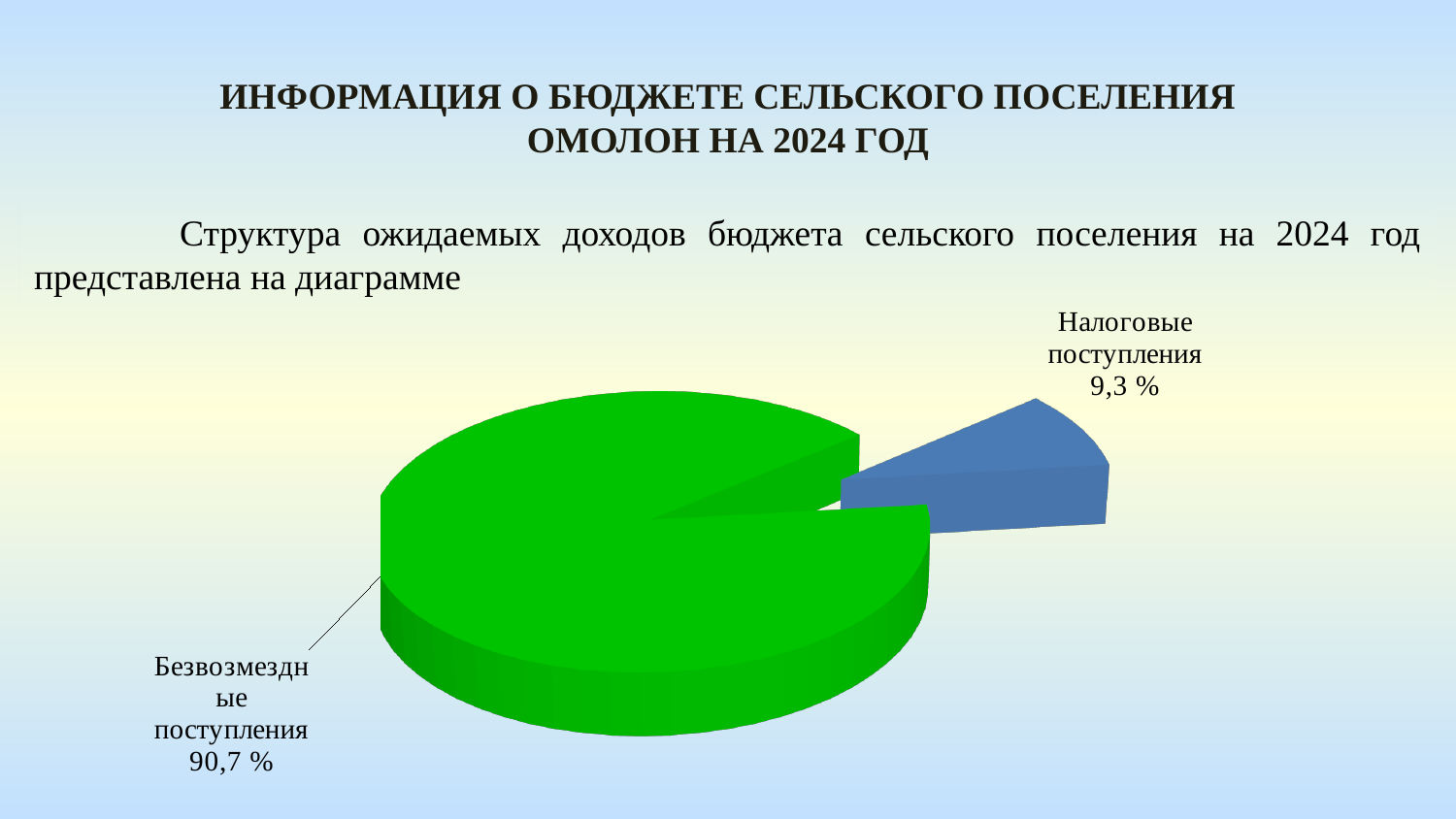
Which slice of the pie is the largest? Безвозмездные поступления What kind of chart is shown on the slide? pie chart Which is larger: the share for "Безвозмездные поступления" or the share for "Налоговые поступления"? Безвозмездные поступления Which slice of the pie is the smallest? Налоговые поступления What share of the pie is labelled "Налоговые поступления"? 9,3 % What colour is the slice for "Налоговые поступления"? blue What colour is the slice for "Безвозмездные поступления"? green How many slices does the pie chart have? 2 What is the difference in percentage points between the "Безвозмездные поступления" slice and the "Налоговые поступления" slice? 81,4 % What share of the pie is labelled "Безвозмездные поступления"? 90,7 %